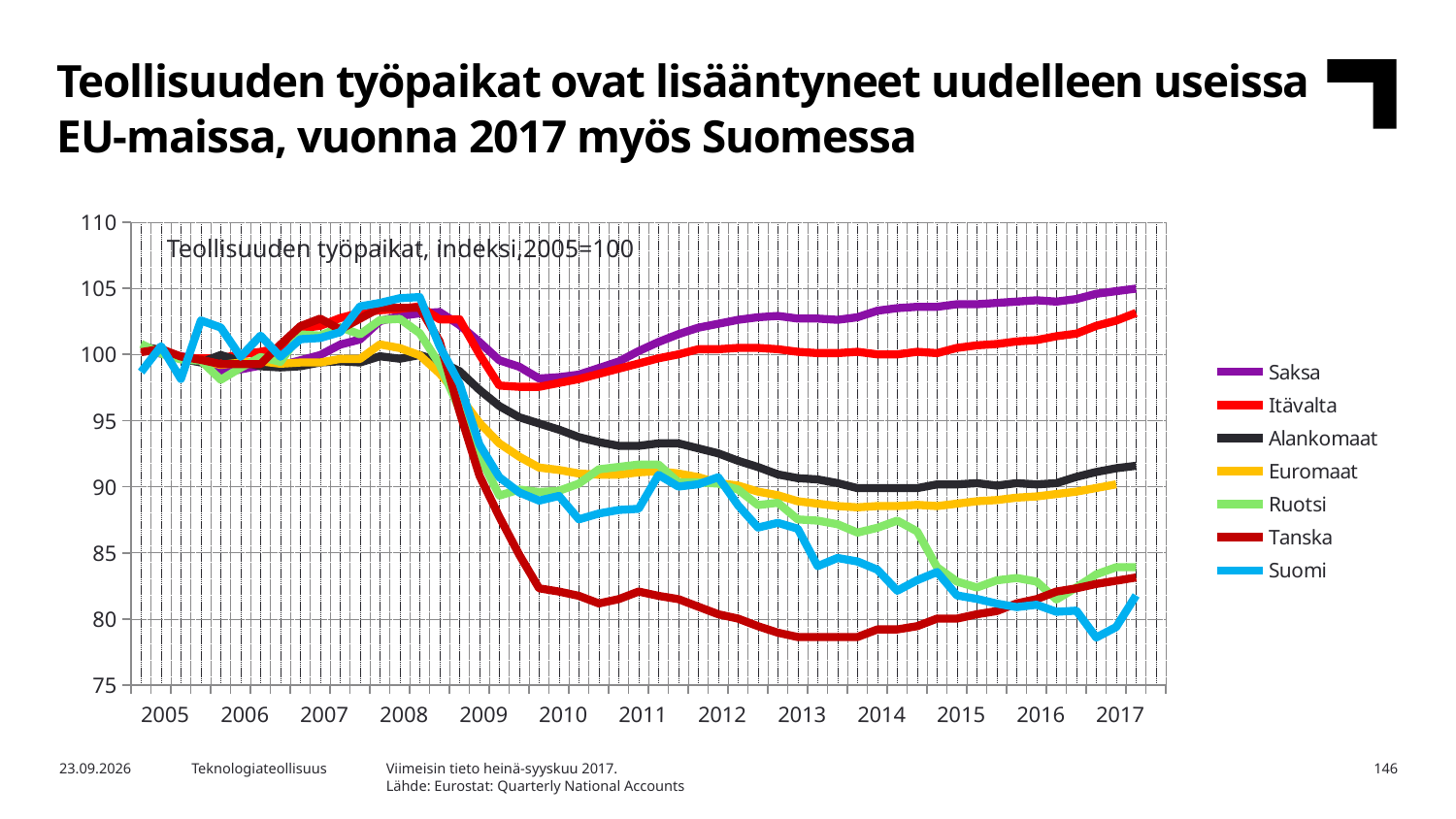
How many series does the legend list? 7 Is the value for Alankomaat in 2011 greater or less than 95? less What kind of chart is shown on the slide? line chart What is the title printed inside the chart area? Teollisuuden työpaikat, indeksi,2005=100 Which series is shown in purple in the legend? Saksa Which series has the highest value at the end of 2017? Saksa Is the value for Tanska in 2013 greater or less than 80? less Is the value for Saksa in 2017 greater or less than 100? greater Does the Tanska line rise or fall between 2008 and 2010? fall How many years are labelled on the x axis? 13 In 2015, which is larger, the value for Saksa or the value for Tanska? Saksa